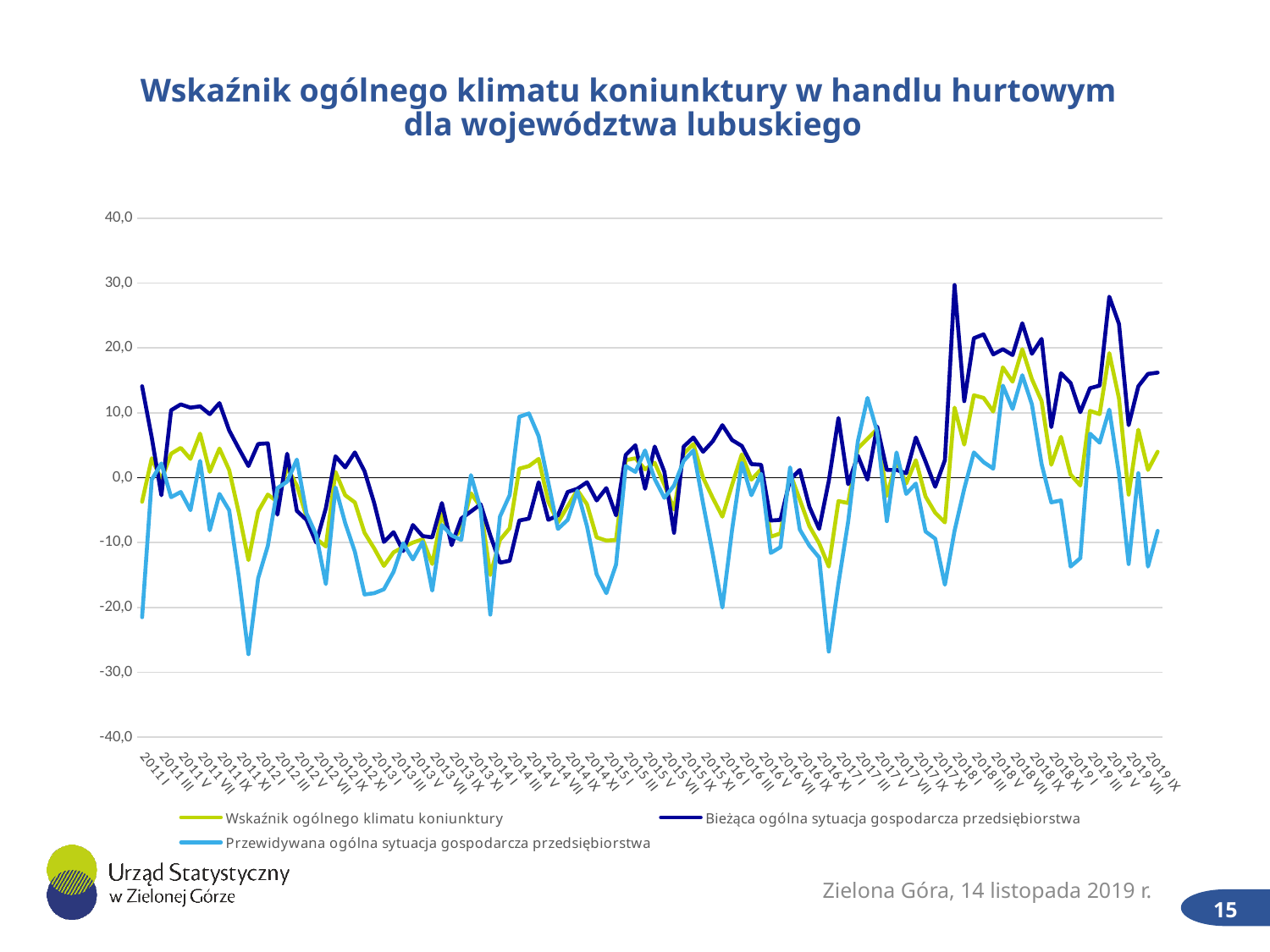
Is the value of Bieżąca ogólna sytuacja gospodarcza przedsiębiorstwa at 2011 I greater or less than 10,0? greater Which series is drawn in the yellow-green colour? Wskaźnik ogólnego klimatu koniunktury At 2019 IX, which is larger: Bieżąca ogólna sytuacja gospodarcza przedsiębiorstwa or Przewidywana ogólna sytuacja gospodarcza przedsiębiorstwa? Bieżąca ogólna sytuacja gospodarcza przedsiębiorstwa Is the value of Przewidywana ogólna sytuacja gospodarcza przedsiębiorstwa at 2019 IX greater or less than 0,0? less Which series reaches the lowest value anywhere on the chart? Przewidywana ogólna sytuacja gospodarcza przedsiębiorstwa Which series reaches the highest value anywhere on the chart? Bieżąca ogólna sytuacja gospodarcza przedsiębiorstwa What is the title of the chart? Wskaźnik ogólnego klimatu koniunktury w handlu hurtowym dla województwa lubuskiego How many series does the legend list? 3 Is the value of Bieżąca ogólna sytuacja gospodarcza przedsiębiorstwa at 2019 IX greater or less than 10,0? greater What kind of chart is shown on the slide? line chart